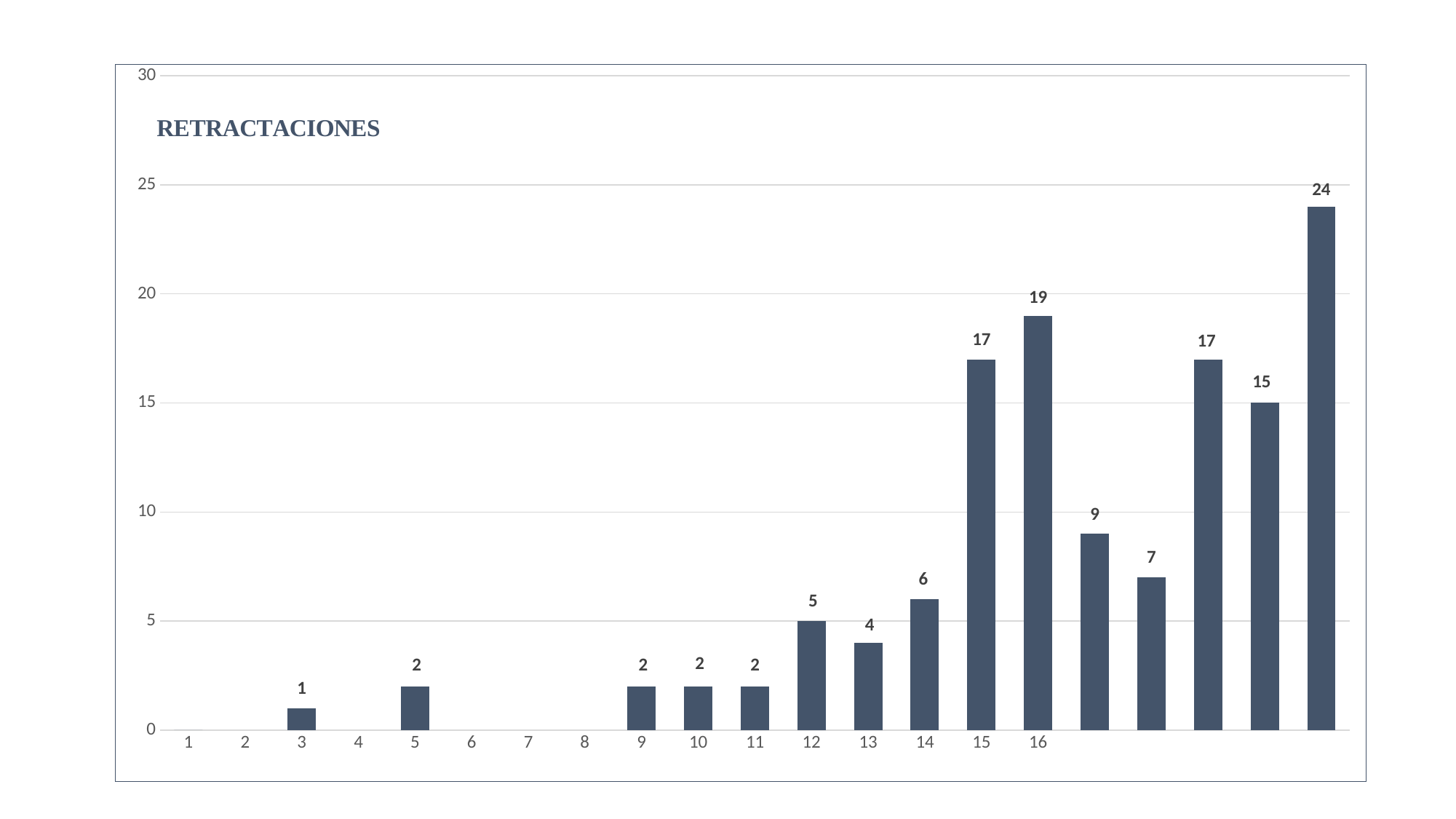
What is the value for category 16? 19 What is the value for category 12? 5 What is the value for category 14? 6 What is the value for category 15? 17 Which is larger, the value for category 13 or the value for category 14? category 14 Is the value for category 16 greater or less than 15? greater What is the value for category 3? 1 What kind of chart is shown on the slide? bar chart What is the largest value printed on any bar in the chart? 24 What is the title of the chart? RETRACTACIONES Do the values generally rise or fall from category 9 to category 16? rise What is the difference between the values for category 16 and category 15? 2